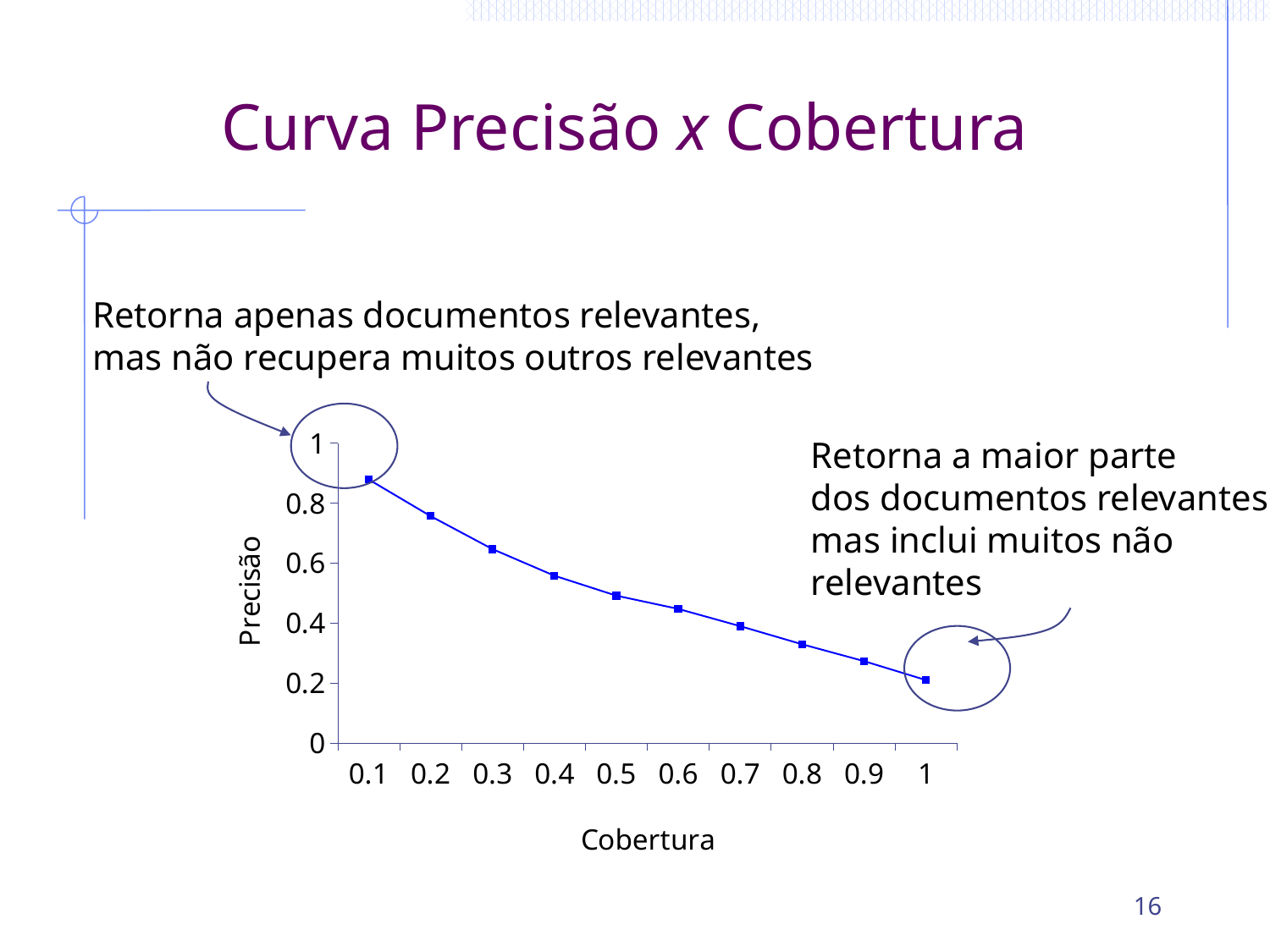
What is the label of the y axis? Precisão Do the values of Precisão rise or fall as Cobertura increases along the x axis? fall How many data points are plotted on the curve? 10 Is the Precisão value at Cobertura 0.3 greater or less than 0.6? greater At which Cobertura value is Precisão lowest? 1 Is the Precisão value at Cobertura 0.1 greater or less than 0.8? greater Which has a higher Precisão value: Cobertura 0.2 or Cobertura 0.7? Cobertura 0.2 Is the Precisão value at Cobertura 0.8 greater or less than 0.4? less At which Cobertura value is Precisão highest? 0.1 What is the label of the x axis? Cobertura What kind of chart is shown on the slide? line chart